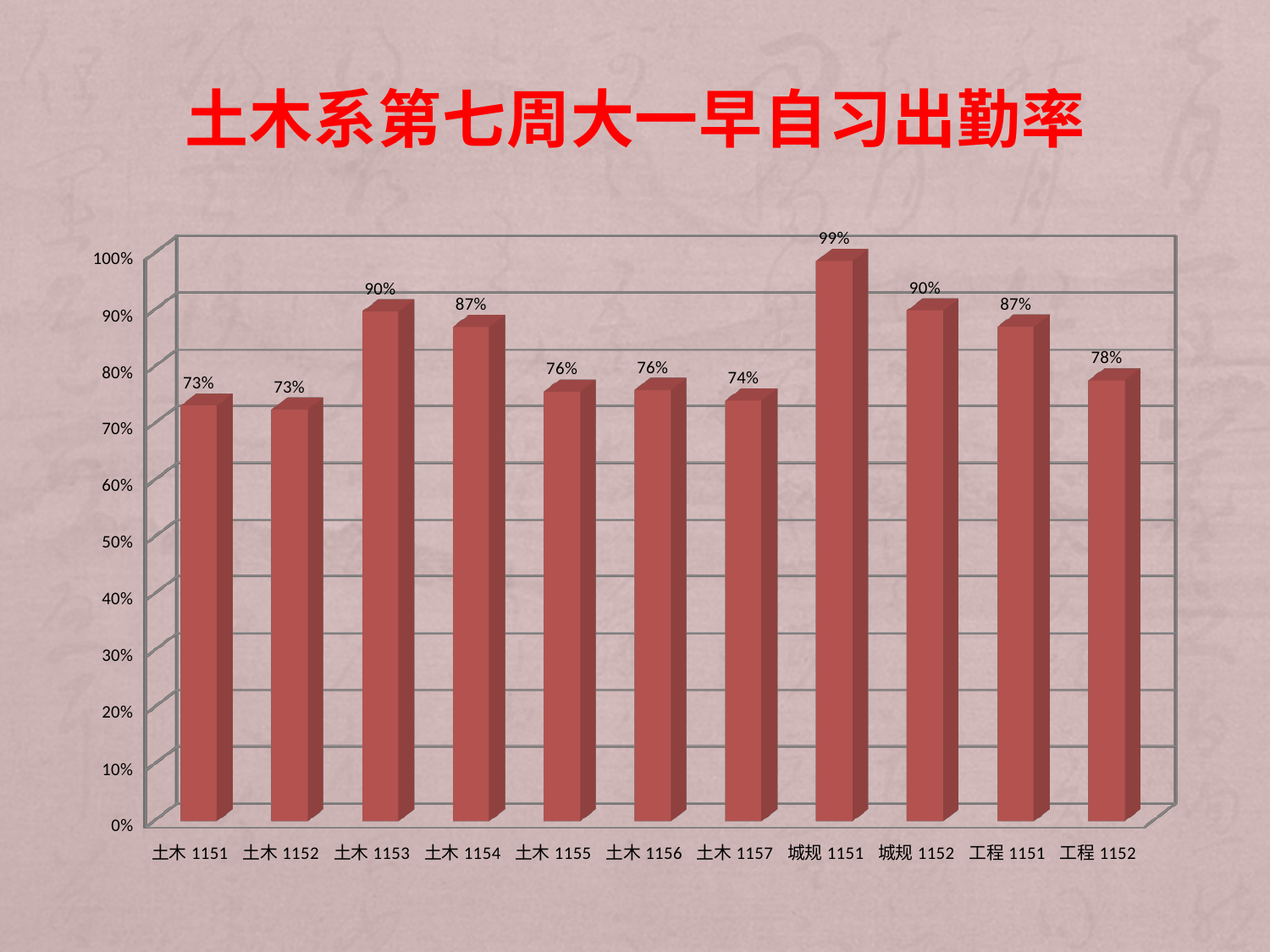
What is the attendance rate for 工程 1152? 78% What is the attendance rate for 城规 1151? 99% What is the attendance rate for 土木 1154? 87% Which class has the highest attendance rate? 城规 1151 What kind of chart is shown on the slide? Bar chart Which has a higher attendance rate, 土木 1153 or 土木 1157? 土木 1153 What is the title of the slide? 土木系第七周大一早自习出勤率 Which has a higher attendance rate, 工程 1151 or 工程 1152? 工程 1151 How many classes are shown on the chart? 11 What is the attendance rate for 土木 1157? 74% What is the difference between the attendance rates of 土木 1153 and 土木 1155? 14% What is the difference between the attendance rates of 城规 1151 and 土木 1151? 26%